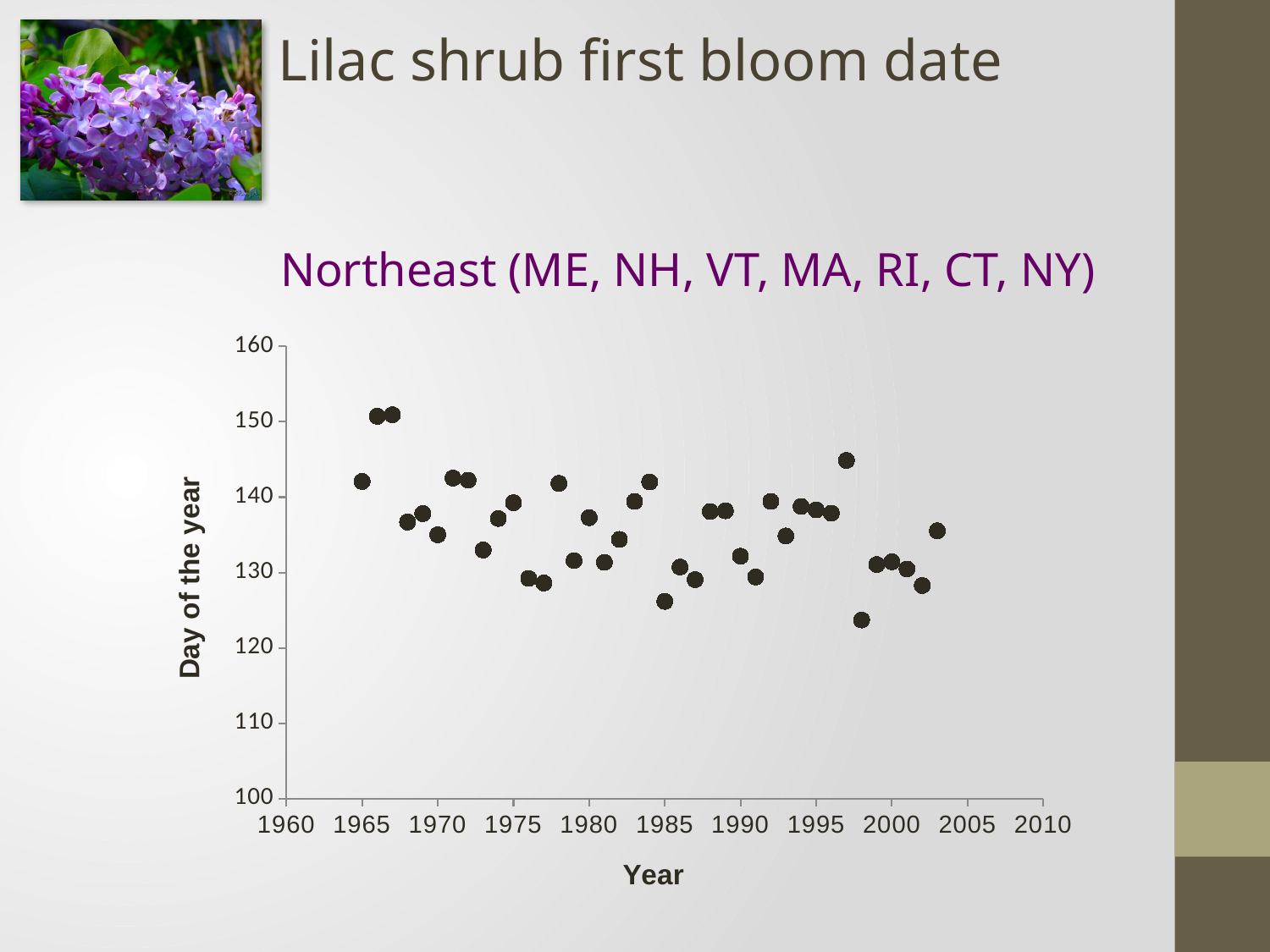
Is the value for 1998 greater or less than 130? less What is the label of the vertical axis? Day of the year Which is larger, the value for 1965 or the value for 1998? 1965 What is the title of the chart? Northeast (ME, NH, VT, MA, RI, CT, NY) Is the value for 1993 greater or less than 140? less Is the value for 1985 greater or less than 130? less What kind of chart is shown on the slide? scatter plot Do the first bloom dates generally rise or fall from 1965 to 2003? fall Which year has the lowest first bloom day of the year? 1998